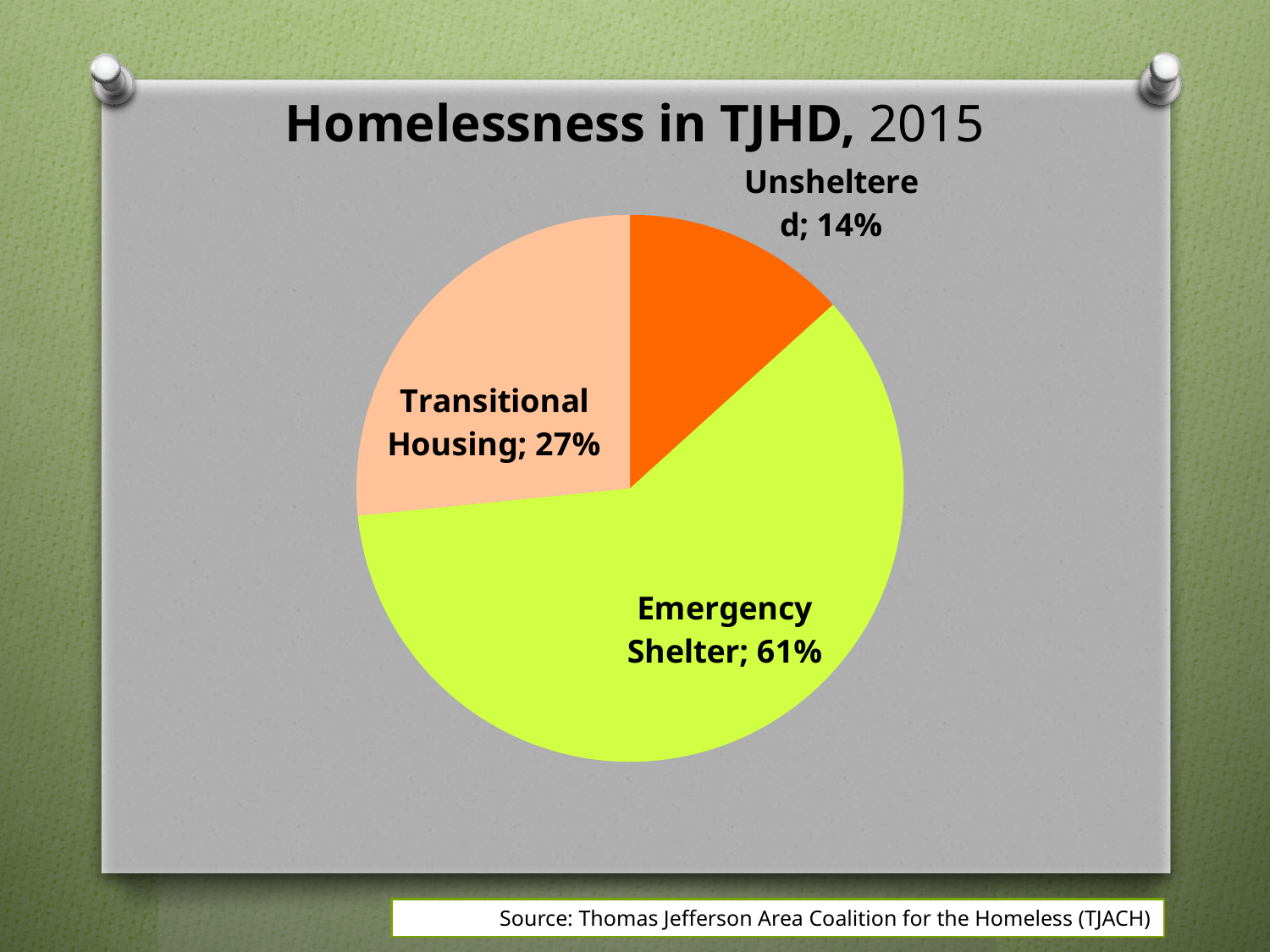
How many slices does the pie chart have? 3 What is the title of the chart? Homelessness in TJHD, 2015 Which is larger, the Transitional Housing slice or the Unsheltered slice? Transitional Housing What is the difference in percentage points between Transitional Housing and Unsheltered? 13 Which category has the smallest slice of the pie? Unsheltered What share of the pie does Transitional Housing represent? 27% What colour is the Emergency Shelter slice? yellow-green What share of the pie does Emergency Shelter represent? 61% What kind of chart is shown on the slide? pie chart What is the difference in percentage points between Emergency Shelter and Transitional Housing? 34 Which category has the largest slice of the pie? Emergency Shelter What is the value shown for Unsheltered? 14%